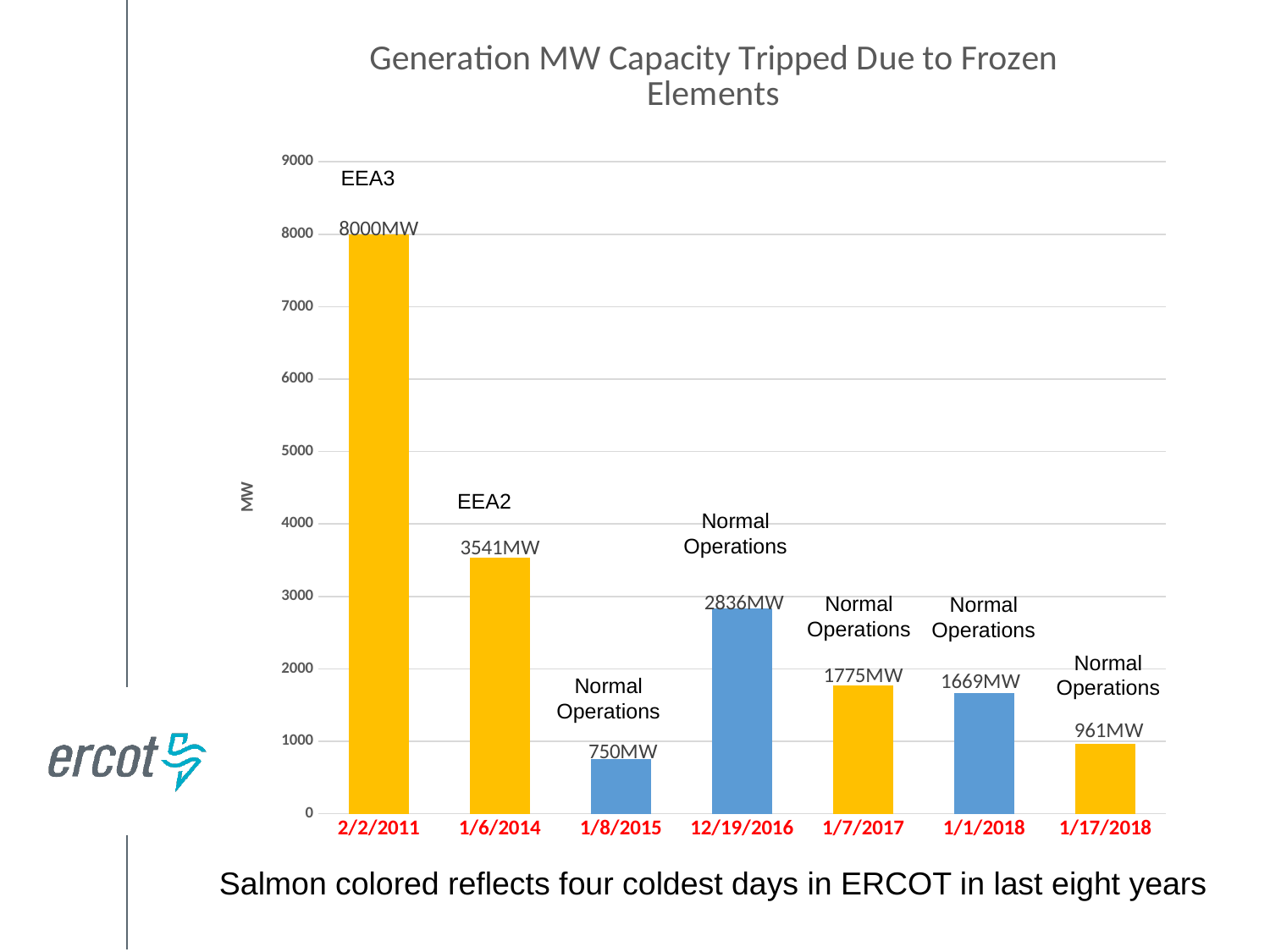
What is the value for 2/2/2011? 8000MW Which date has the lowest MW capacity tripped? 1/8/2015 What is the title of the chart? Generation MW Capacity Tripped Due to Frozen Elements Which is larger, the value for 1/8/2015 or the value for 1/17/2018? 1/17/2018 What is the difference between the values for 1/7/2017 and 1/1/2018? 106MW What is the value for 1/17/2018? 961MW Which date has the highest MW capacity tripped? 2/2/2011 What is the difference between the values for 1/6/2014 and 12/19/2016? 705MW What is the value for 12/19/2016? 2836MW How many dates are shown on the x axis? 7 What kind of chart is this? bar chart Is the value for 1/6/2014 greater or less than 3000? greater